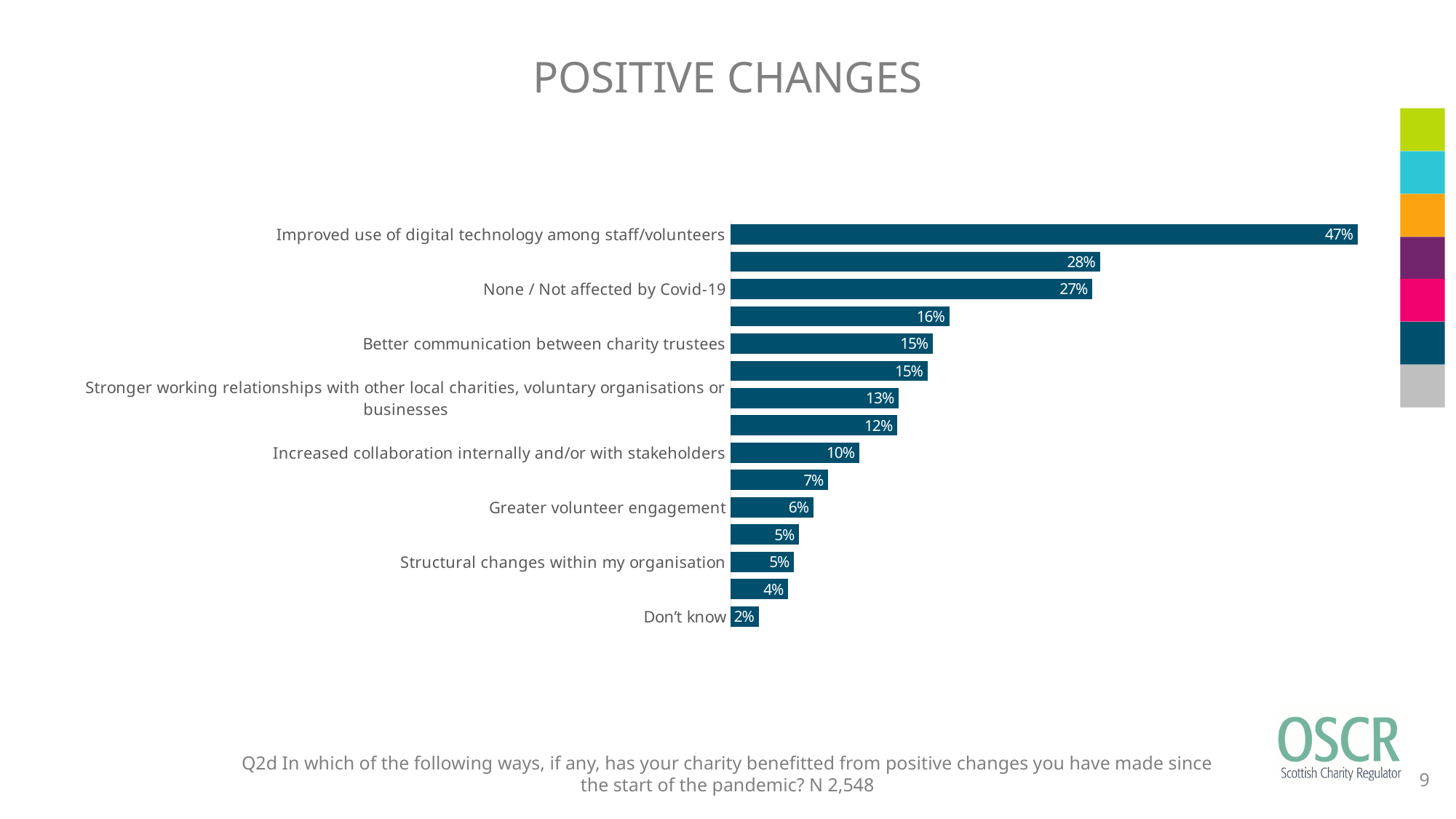
Which is larger: 'Structural changes within my organisation' or 'Greater volunteer engagement'? Greater volunteer engagement What type of chart is shown on the slide? Bar chart What is the value for 'Don't know'? 2% What is the difference between 'Improved use of digital technology among staff/volunteers' and 'None / Not affected by Covid-19'? 20 percentage points What is the value for 'None / Not affected by Covid-19'? 27% What is the value for 'Greater volunteer engagement'? 6% What is the value for 'Better communication between charity trustees'? 15% Which category has the highest value? Improved use of digital technology among staff/volunteers How many bars are plotted in the chart? 15 Which category has the lowest value? Don't know What is the value for 'Increased collaboration internally and/or with stakeholders'? 10% What percentage of respondents selected 'Improved use of digital technology among staff/volunteers'? 47%